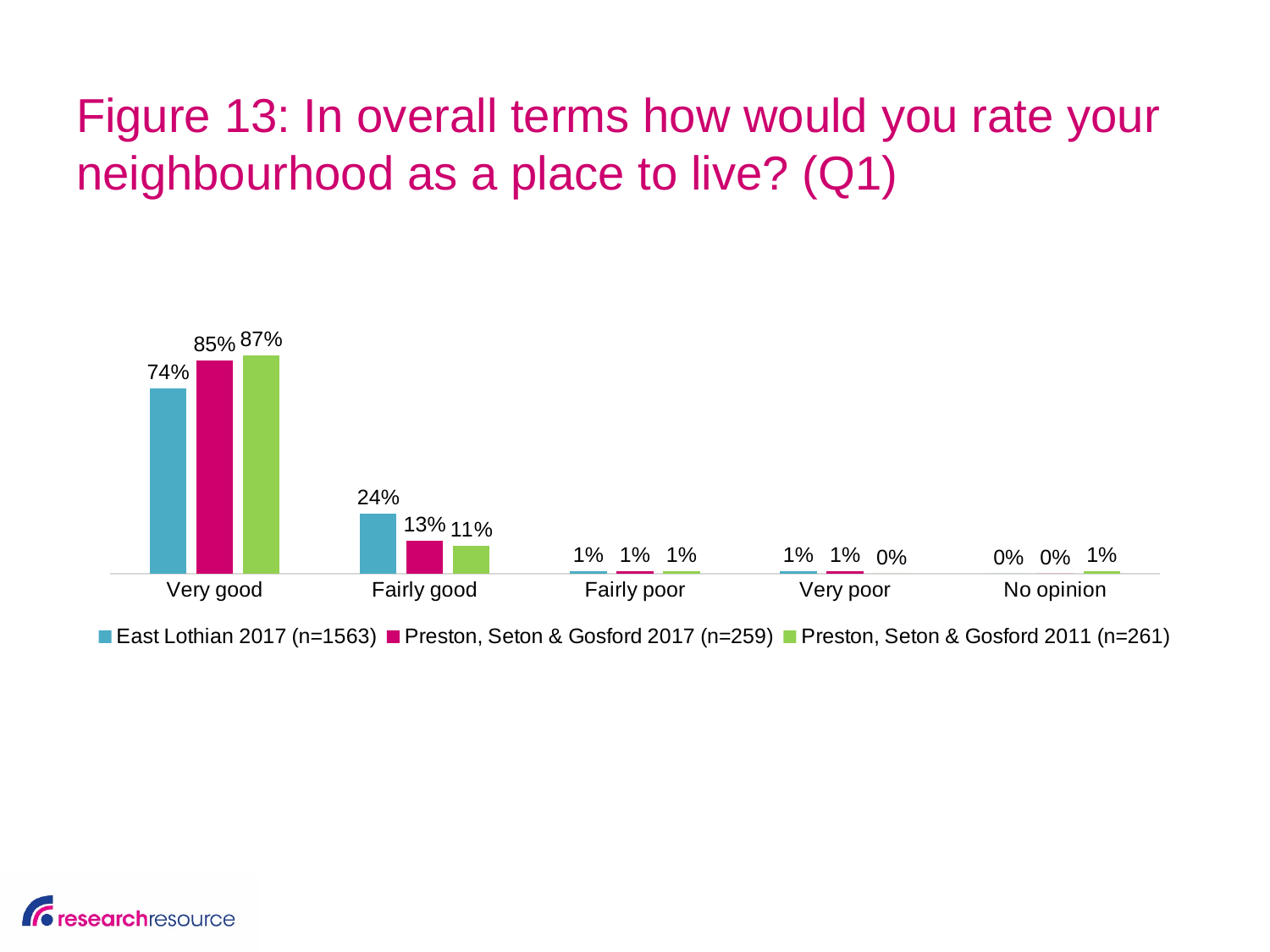
Which series has the highest value in the Very good category? Preston, Seton & Gosford 2011 (n=261) In the Fairly good category, which is larger: East Lothian 2017 or Preston, Seton & Gosford 2011? East Lothian 2017 What percentage of East Lothian 2017 respondents rated their neighbourhood as Very good? 74% What is the value for Preston, Seton & Gosford 2011 in the Fairly good category? 11% How many series does the legend list? 3 What is the difference between the Very good values for Preston, Seton & Gosford 2011 and East Lothian 2017? 13% Which category has the highest value for East Lothian 2017? Very good How many response categories are shown on the x axis? 5 What kind of chart is shown on the slide? Bar chart What is the difference between the Fairly good values for East Lothian 2017 and Preston, Seton & Gosford 2017? 11% What is the value for Preston, Seton & Gosford 2011 in the Very poor category? 0% What is the value for Preston, Seton & Gosford 2017 in the Very good category? 85%